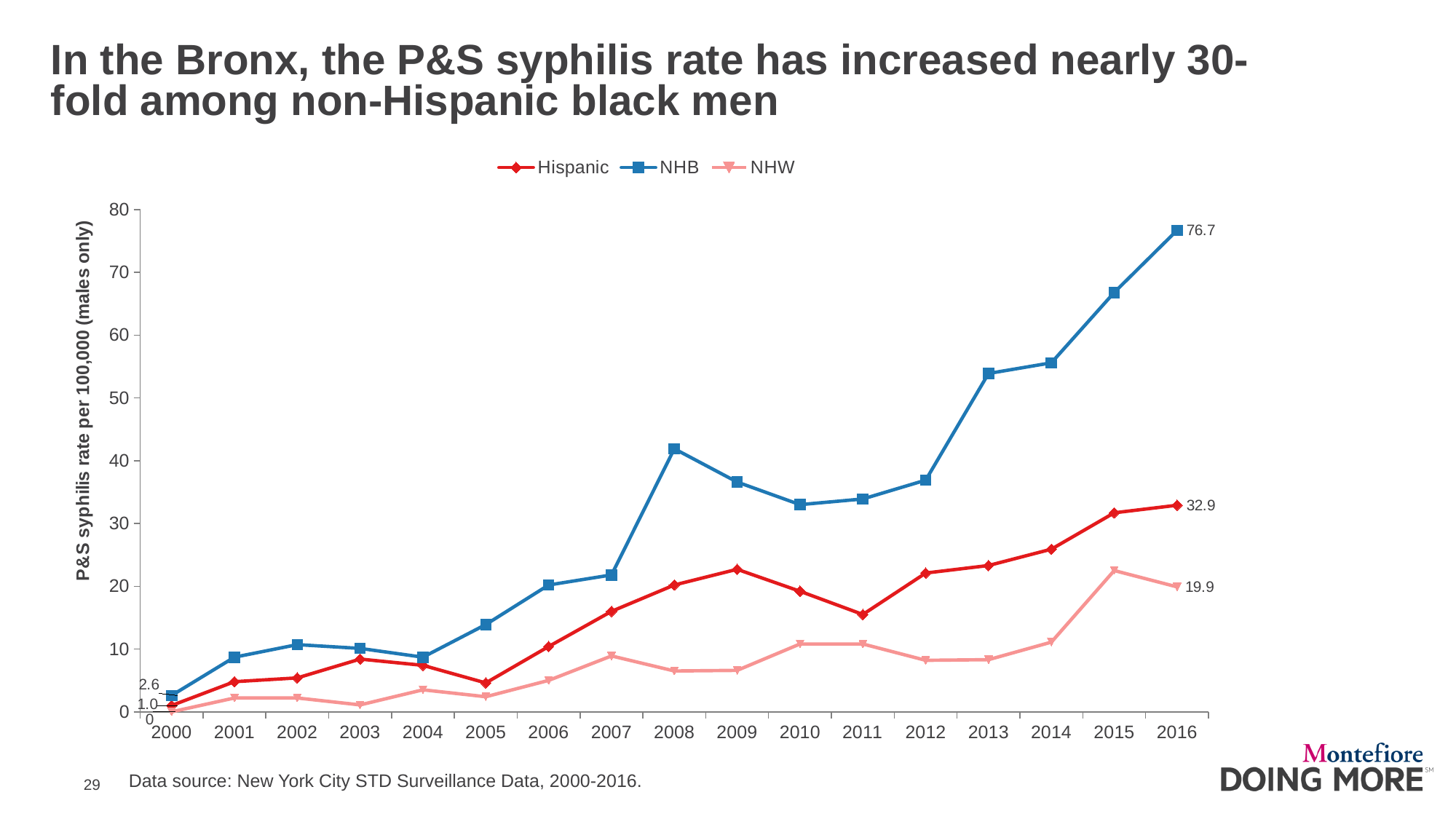
What is the NHB value in 2000? 2.6 By how much did the NHB value increase from 2000 to 2016? 74.1 What is the difference between the NHB and Hispanic values in 2016? 43.8 What is the NHB value in 2016? 76.7 What is the NHW value in 2016? 19.9 Which series has the highest value in 2016? NHB Is the NHB value for 2013 greater or less than 50? greater In 2016, which is larger, the Hispanic value or the NHW value? Hispanic What is the Hispanic value in 2016? 32.9 How many series does the legend list? 3 What kind of chart is shown on the slide? Line chart What is the Hispanic value in 2000? 1.0